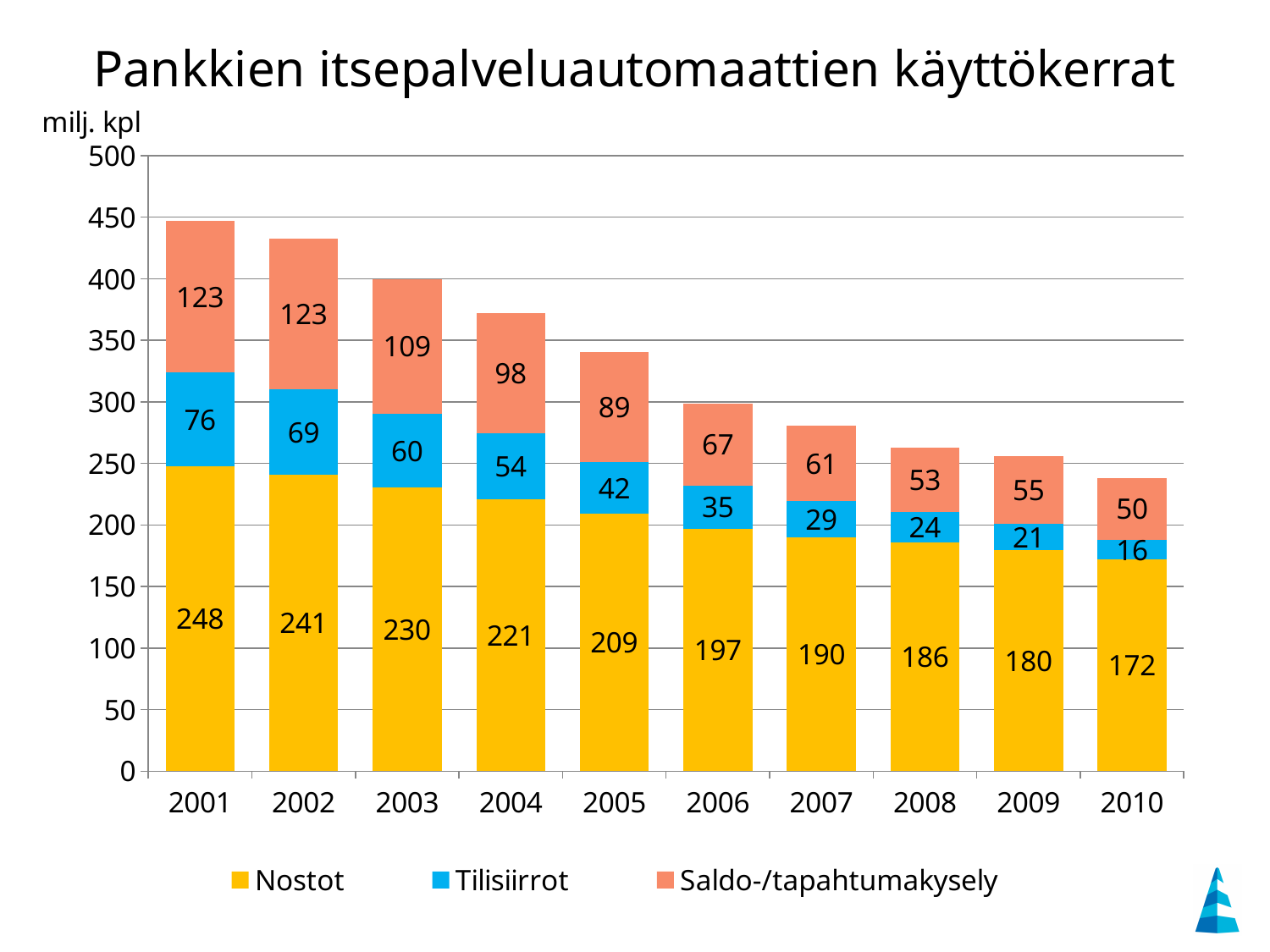
In which year is the Nostot value highest? 2001 What is the total of the stacked bar for 2010? 238 What is the value for Tilisiirrot in 2008? 24 What is the total of the stacked bar for 2001? 447 What is the value for Saldo-/tapahtumakysely in 2003? 109 How many series does the legend list? 3 What is the difference between the Nostot values for 2001 and 2010? 76 What is the value for Nostot in 2005? 209 Do the Nostot values rise or fall from 2001 to 2010? fall How many years are shown on the x axis? 10 Which is larger, the Saldo-/tapahtumakysely value for 2008 or for 2009? 2009 In which year is the Tilisiirrot value lowest? 2010